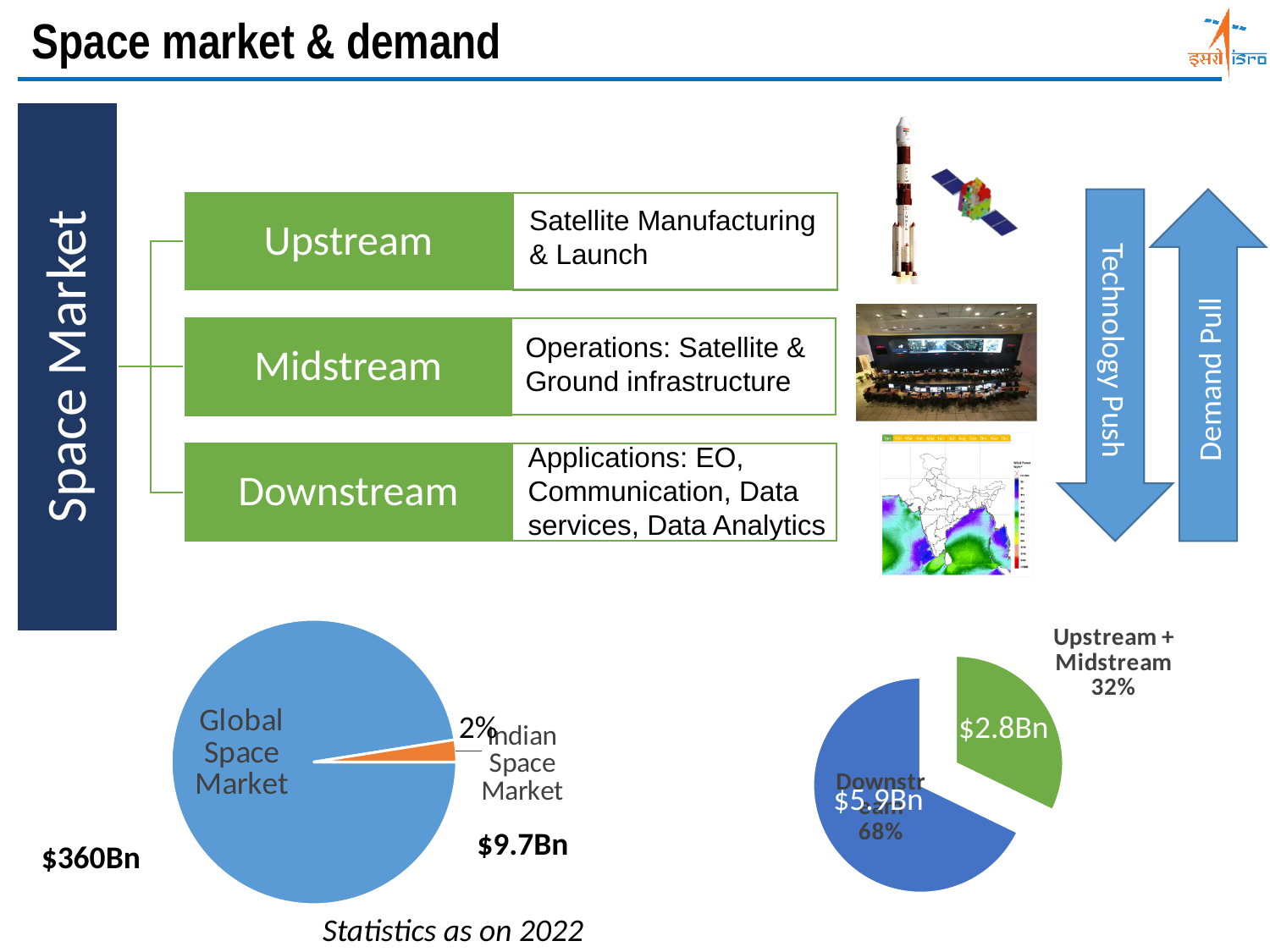
In the right pie chart, what is the difference in percentage points between the Downstream share and the Upstream + Midstream share? 36% In the right pie chart, what value is shown for the Downstream slice? $5.9Bn In the right pie chart, what value is shown for the Upstream + Midstream slice? $2.8Bn In the right pie chart, what share of the pie is Upstream + Midstream? 32% In the left pie chart, which slice is larger, Global Space Market or Indian Space Market? Global Space Market In the left pie chart, what value is shown for the Indian Space Market? $9.7Bn In the left pie chart, what value is shown for the Global Space Market? $360Bn In the right pie chart, what share of the pie is Downstream? 68% How many slices does the right pie chart have? 2 In the right pie chart, which slice is the largest? Downstream In the left pie chart, what share of the pie does the Indian Space Market slice represent? 2% What kind of chart is the left chart showing the Global Space Market and Indian Space Market? pie chart